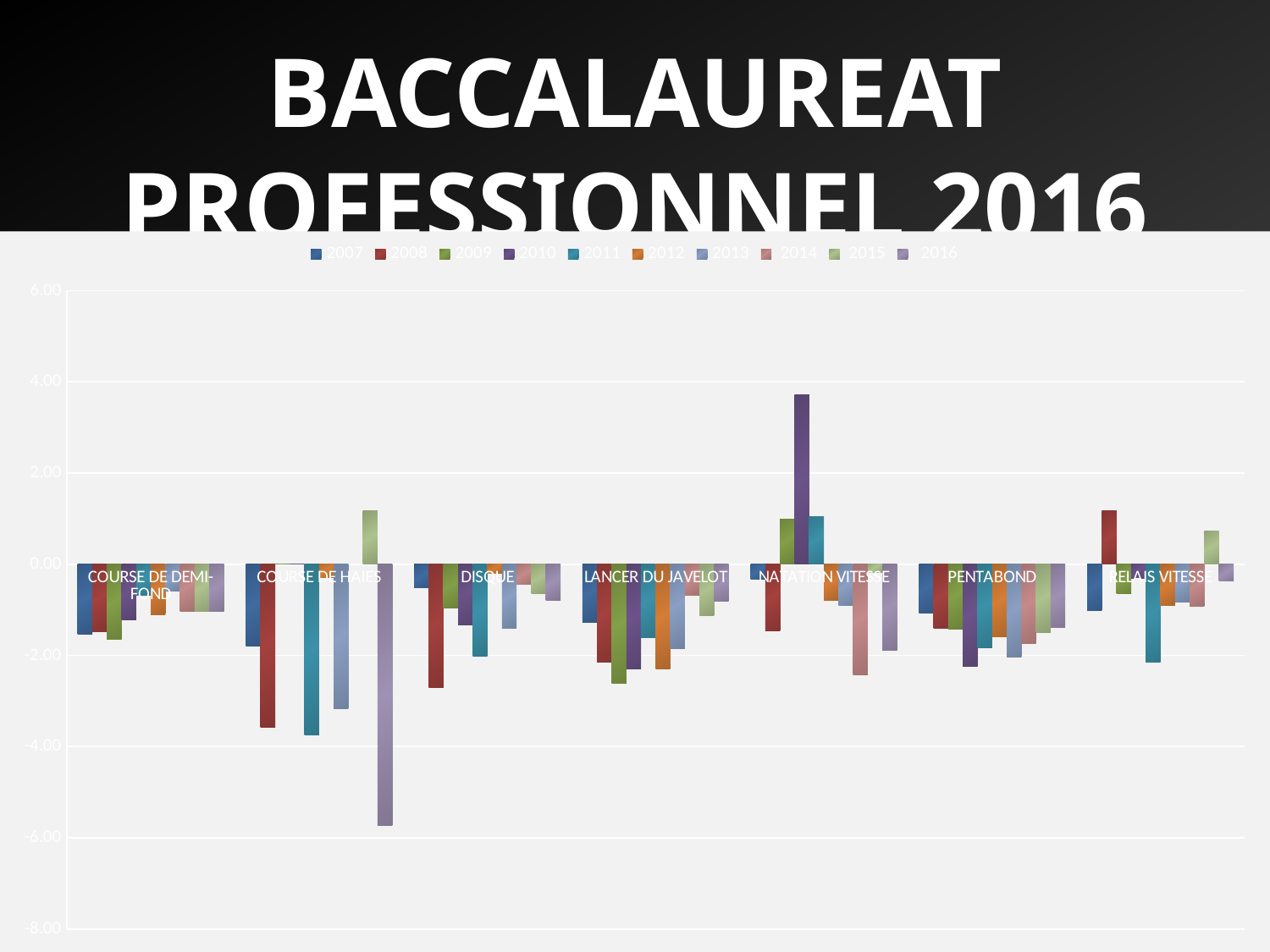
Which series has the highest value in the NATATION VITESSE category? 2010 How many series does the chart's legend list? 10 Which category contains the highest bar in the chart? NATATION VITESSE Is the value for 2016 in COURSE DE HAIES greater or less than -4.00? less Which series has the lowest value in the COURSE DE HAIES category? 2016 How many categories are shown along the x axis of the chart? 7 Which is larger: the value for 2008 in COURSE DE HAIES or the value for 2008 in DISQUE? 2008 in DISQUE Which year is listed first in the chart's legend? 2007 Is the value for 2008 in DISQUE greater or less than -2.00? less Is the value for 2010 in NATATION VITESSE greater or less than 2.00? greater Which category contains the lowest bar in the chart? COURSE DE HAIES What kind of chart is shown on the slide? bar chart